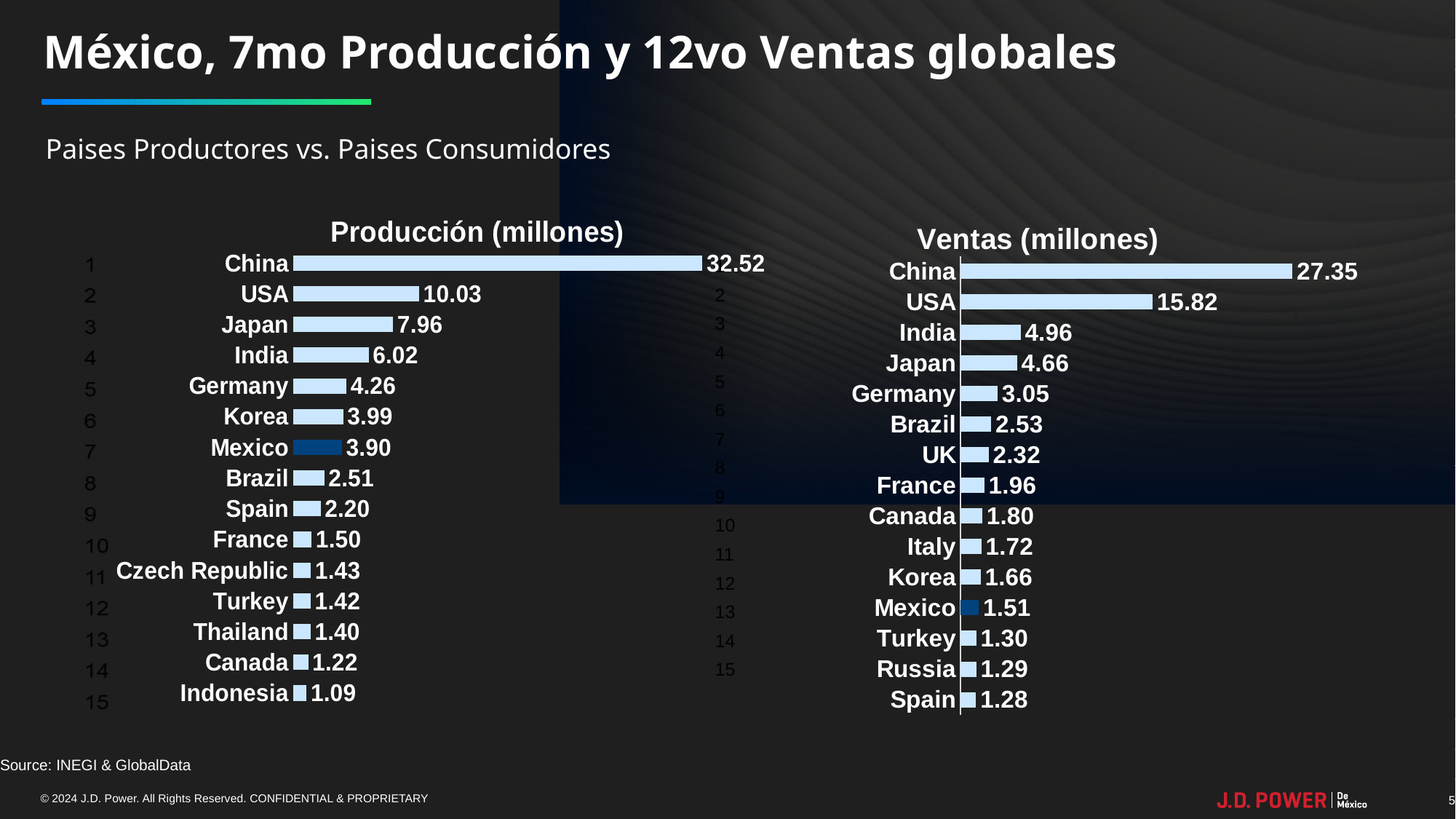
How many countries are shown in the 'Ventas (millones)' chart? 15 In the 'Producción (millones)' chart, what is the difference between the values for China and USA? 22.49 What kind of chart is the 'Ventas (millones)' chart? Bar chart In the 'Ventas (millones)' chart, what is the value for India? 4.96 In the 'Producción (millones)' chart, which is larger, the value for Japan or the value for India? Japan In the 'Ventas (millones)' chart, which country has the lowest value? Spain In the 'Producción (millones)' chart, which country has the highest value? China In the 'Producción (millones)' chart, what is the value for Czech Republic? 1.43 In the 'Producción (millones)' chart, what is the value for Mexico? 3.90 How many countries are shown in the 'Producción (millones)' chart? 15 In the 'Ventas (millones)' chart, what is the difference between the values for USA and India? 10.86 In the 'Ventas (millones)' chart, which is larger, the value for Brazil or the value for Germany? Germany